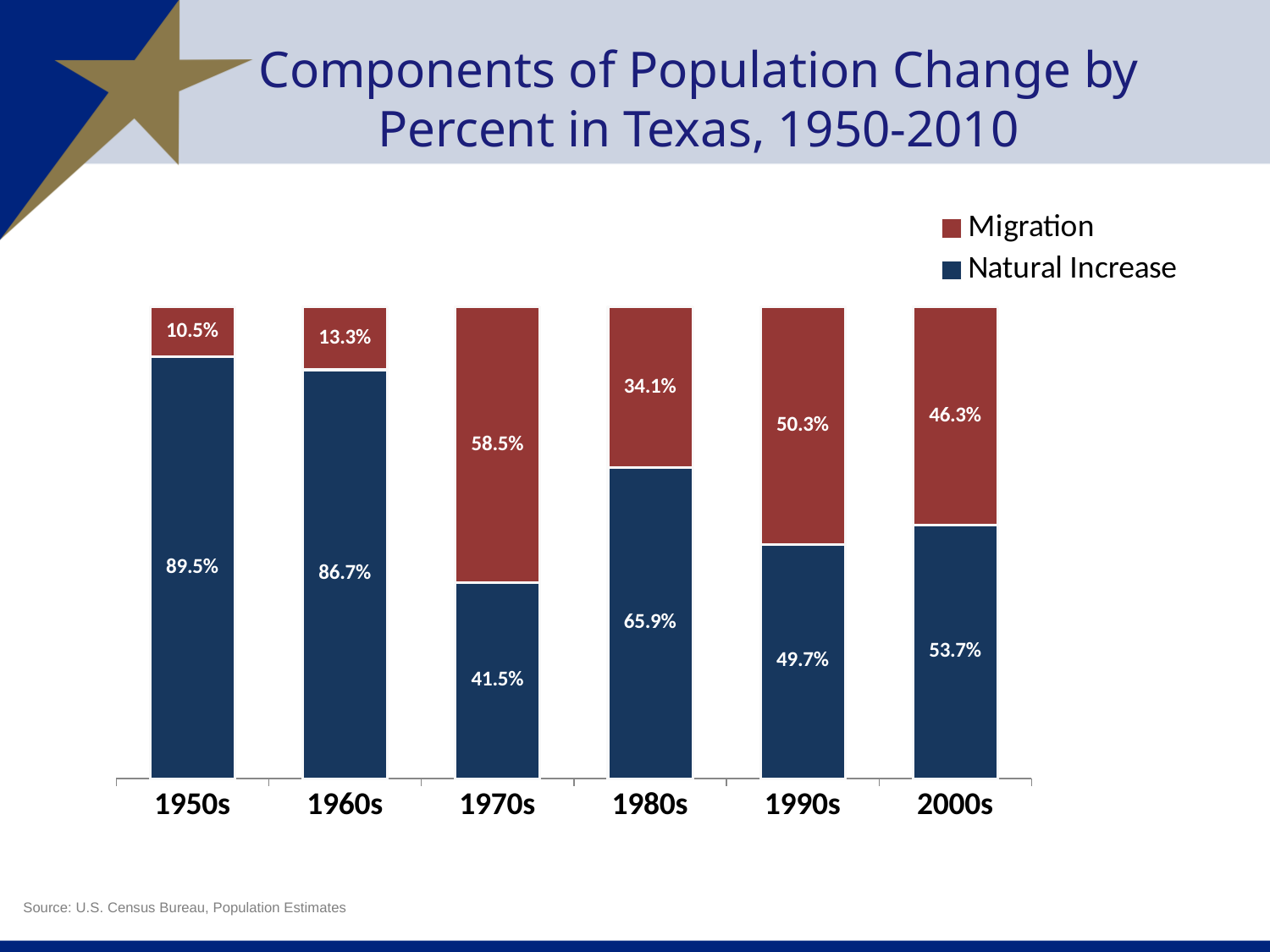
What kind of chart is shown on the slide? Stacked bar chart What is the Natural Increase value for the 1950s? 89.5% Which is larger in the 1990s, Migration or Natural Increase? Migration Which decade has the highest Migration value? 1970s What is the Migration value for the 2000s? 46.3% What is the Natural Increase value for the 1980s? 65.9% How many series does the legend list? 2 How many decades are shown on the x axis? 6 Which decade has the lowest Natural Increase value? 1970s Which series is shown in red? Migration What is the difference between the Natural Increase values for the 1950s and the 1960s? 2.8% What is the Migration value for the 1970s? 58.5%